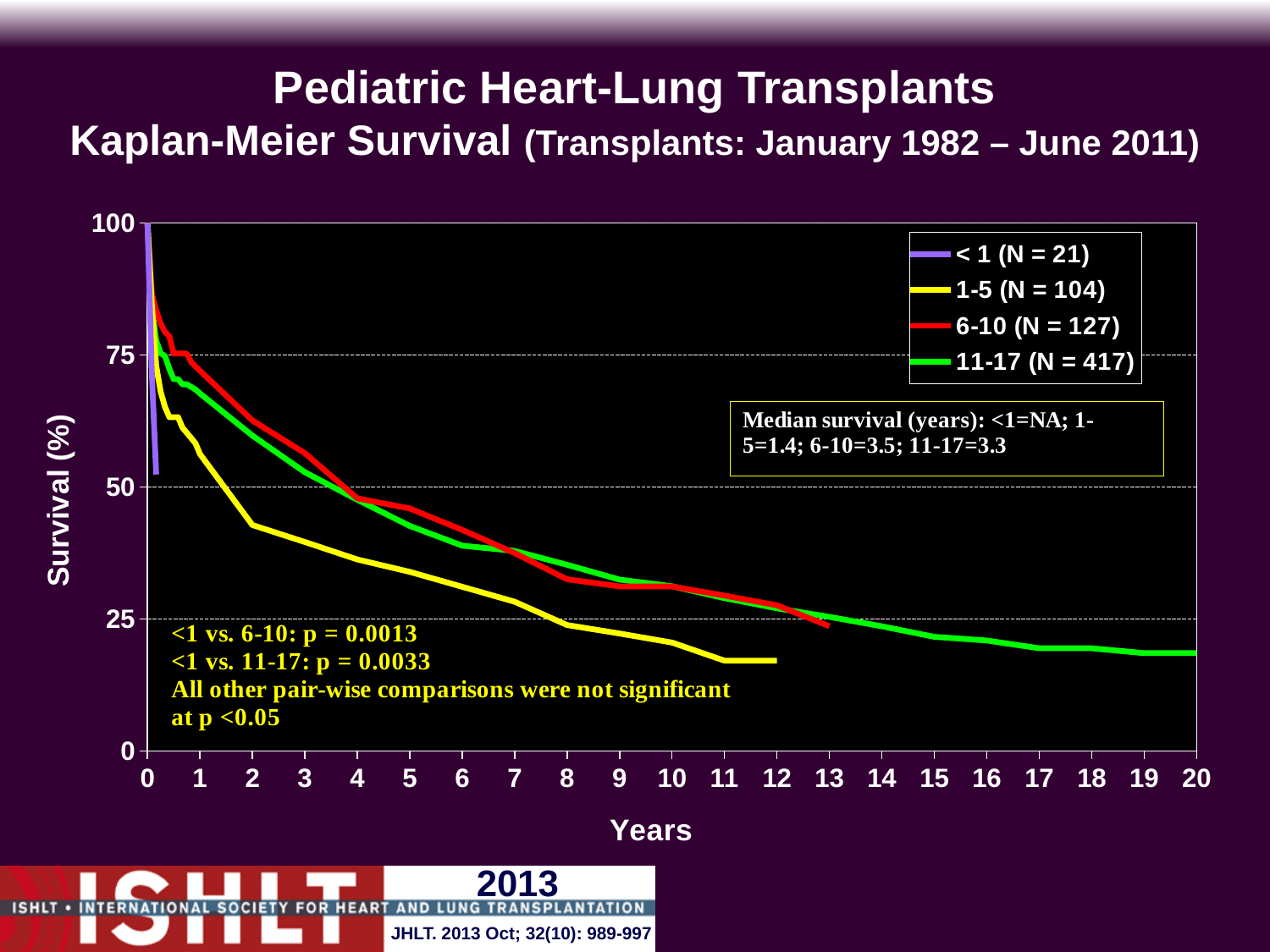
Is the survival for the 6-10 group at 8 years greater or less than 25? greater Which age group has the largest N in the legend? 11-17 (N = 417) How many series does the legend list? 4 What is the median survival in years for the 1-5 group? 1.4 What is the median survival in years for the 6-10 group? 3.5 Do the survival curves rise or fall as years increase? fall According to the legend, what is N for the 11-17 age group? 417 At 2 years, which group has higher survival, 1-5 or 6-10? 6-10 Is the survival for the 1-5 group at 2 years greater or less than 50? less Which group has the lowest survival at 10 years? 1-5 Is the survival for the 11-17 group at 20 years greater or less than 25? less What kind of chart is shown on the slide? line chart